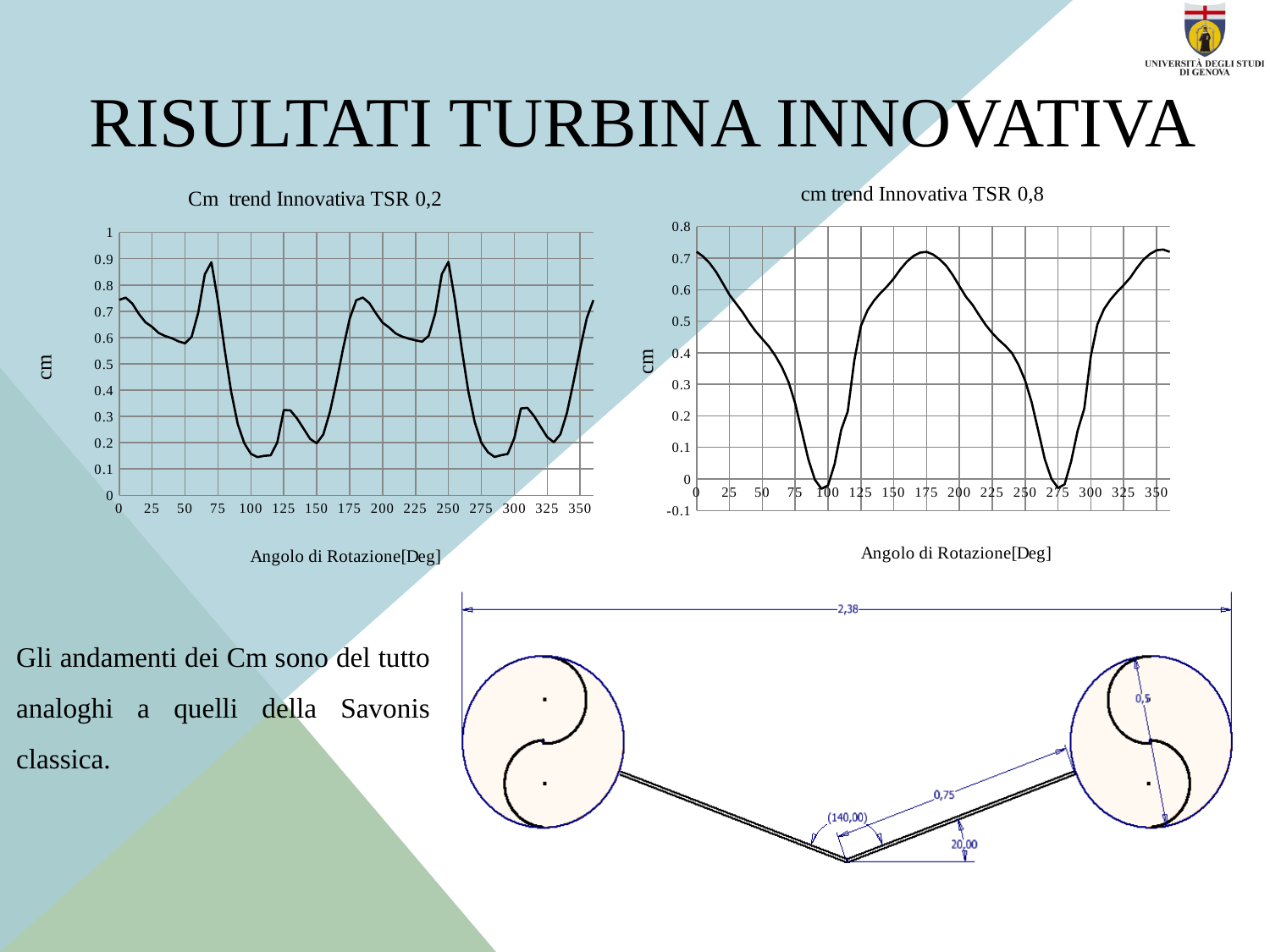
In the right chart "cm trend Innovativa TSR 0,8", is the value at 100 degrees greater or less than 0.3? less What kind of chart is the left chart titled "Cm trend Innovativa TSR 0,2"? line chart In the left chart "Cm trend Innovativa TSR 0,2", is the value at 250 degrees greater or less than 0.5? greater What is the lowest tick shown on the y-axis of the right chart "cm trend Innovativa TSR 0,8"? -0.1 In the left chart "Cm trend Innovativa TSR 0,2", is the value at 100 degrees greater or less than 0.5? less What is the x-axis label of the left chart "Cm trend Innovativa TSR 0,2"? Angolo di Rotazione[Deg] What kind of chart is the right chart titled "cm trend Innovativa TSR 0,8"? line chart In the right chart "cm trend Innovativa TSR 0,8", which is larger: the value at 100 degrees or the value at 175 degrees? 175 degrees In the left chart "Cm trend Innovativa TSR 0,2", which is larger: the value at 100 degrees or the value at 250 degrees? 250 degrees